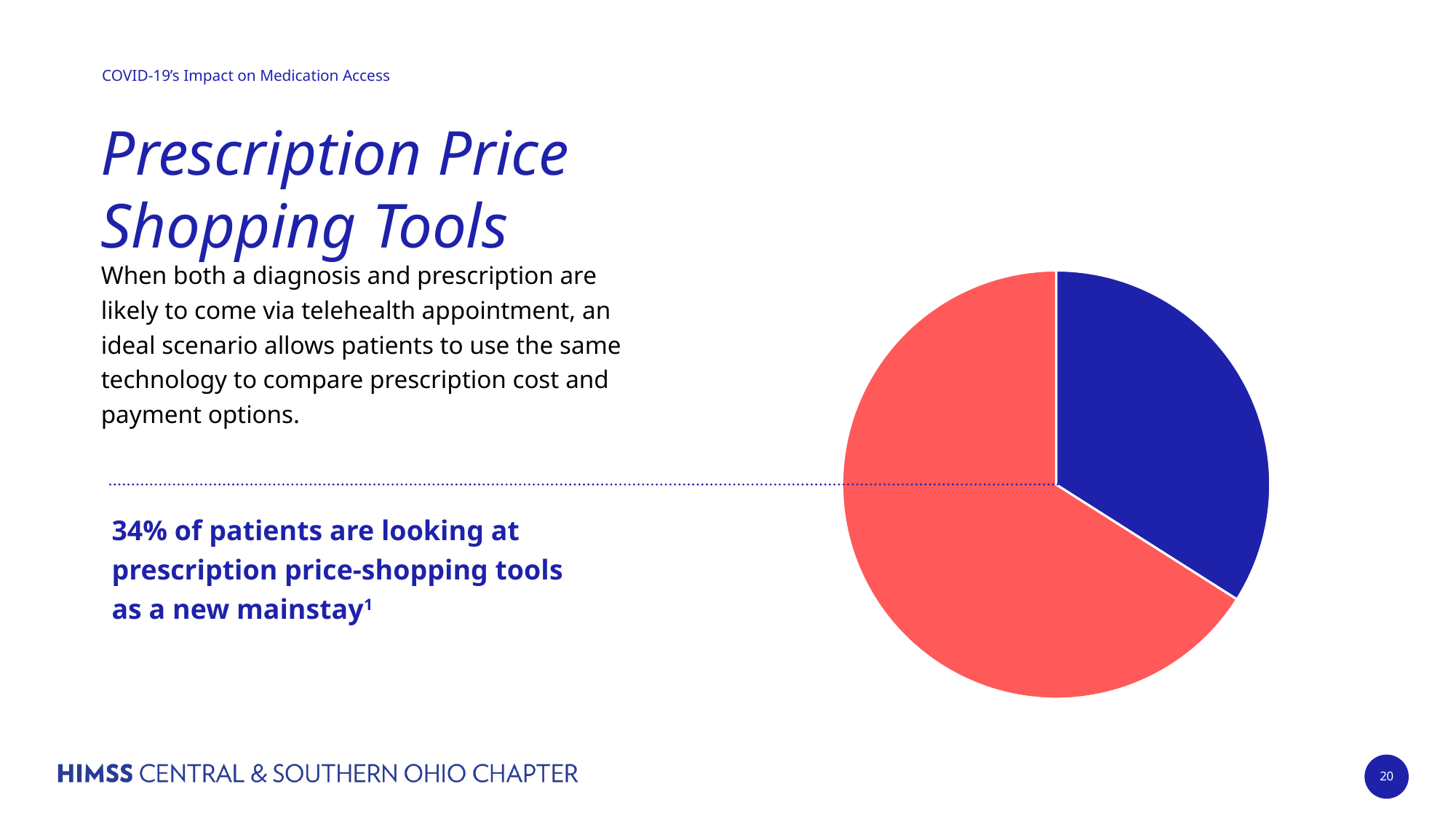
Which slice of the pie chart is larger, the red one or the blue one? the red one How many slices does the pie chart have? 2 What two colours are used for the slices of the pie chart? red and blue Which colour slice is the smallest in the pie chart? blue Which colour slice is the largest in the pie chart? red Does the red slice cover more or less than half of the pie chart? more Does the blue slice cover more or less than half of the pie chart? less What kind of chart is shown on the slide? pie chart Does the pie chart include a legend? No According to the slide text, what share of patients are looking at prescription price-shopping tools as a new mainstay, as represented by the blue slice? 34%